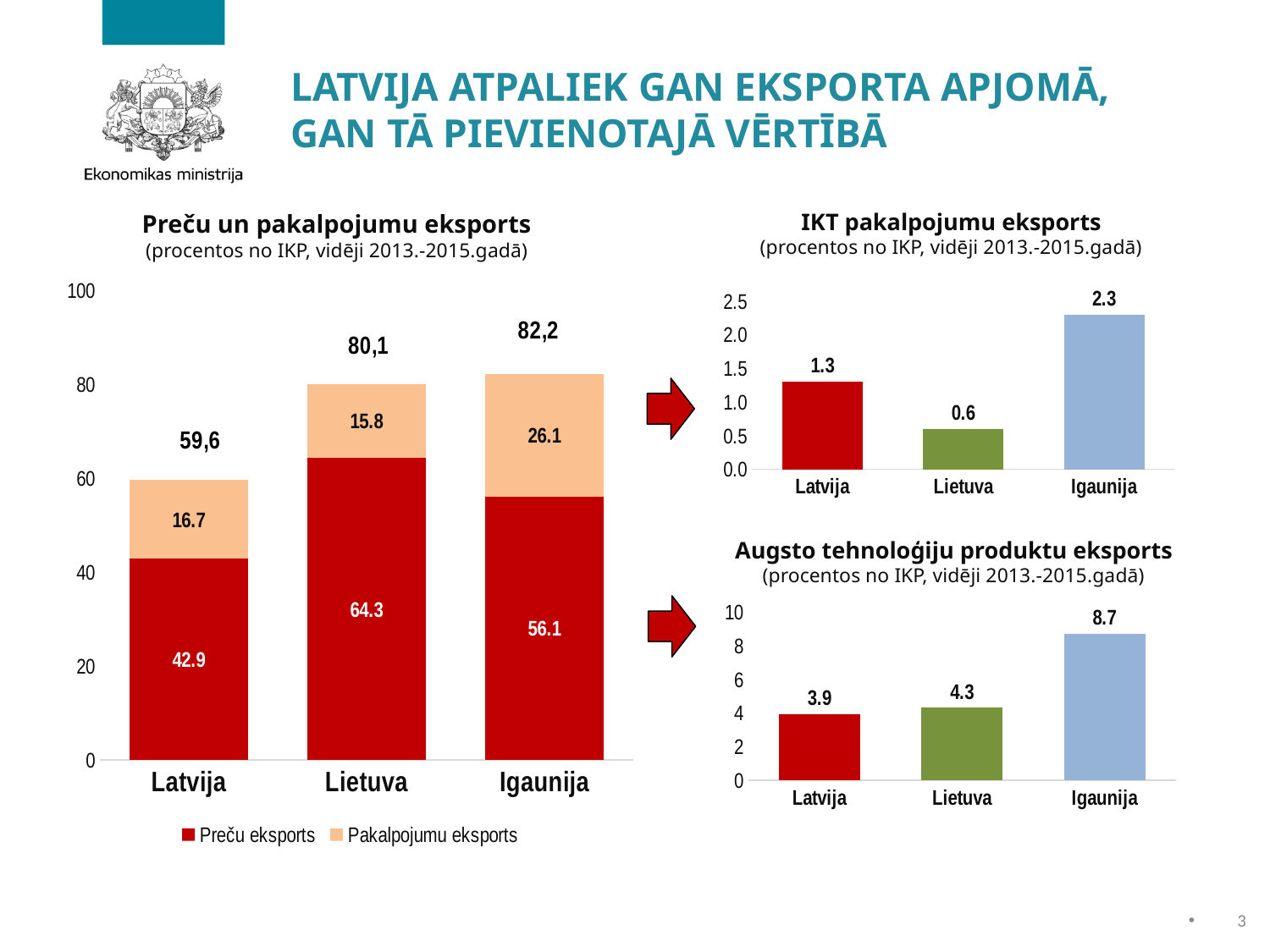
In the 'Preču un pakalpojumu eksports' chart, which country has the highest total? Igaunija In the 'Augsto tehnoloģiju produktu eksports' chart, which is larger, Latvija or Lietuva? Lietuva In the 'Preču un pakalpojumu eksports' chart, how many series does the legend list? 2 In the 'IKT pakalpojumu eksports' chart, which country has the lowest value? Lietuva What kind of chart is the 'Augsto tehnoloģiju produktu eksports' chart? Bar chart In the 'Preču un pakalpojumu eksports' chart, what is the difference between Preču eksports for Lietuva and Latvija? 21.4 In the 'Preču un pakalpojumu eksports' chart, what is the value of Preču eksports for Lietuva? 64.3 In the 'IKT pakalpojumu eksports' chart, what is the difference between Igaunija and Latvija? 1.0 In the 'Preču un pakalpojumu eksports' chart, what is the value of Pakalpojumu eksports for Igaunija? 26.1 In the 'IKT pakalpojumu eksports' chart, what is the value for Lietuva? 0.6 In the 'Augsto tehnoloģiju produktu eksports' chart, what is the value for Igaunija? 8.7 In the 'Preču un pakalpojumu eksports' chart, what is the total of the stacked bar for Latvija? 59,6